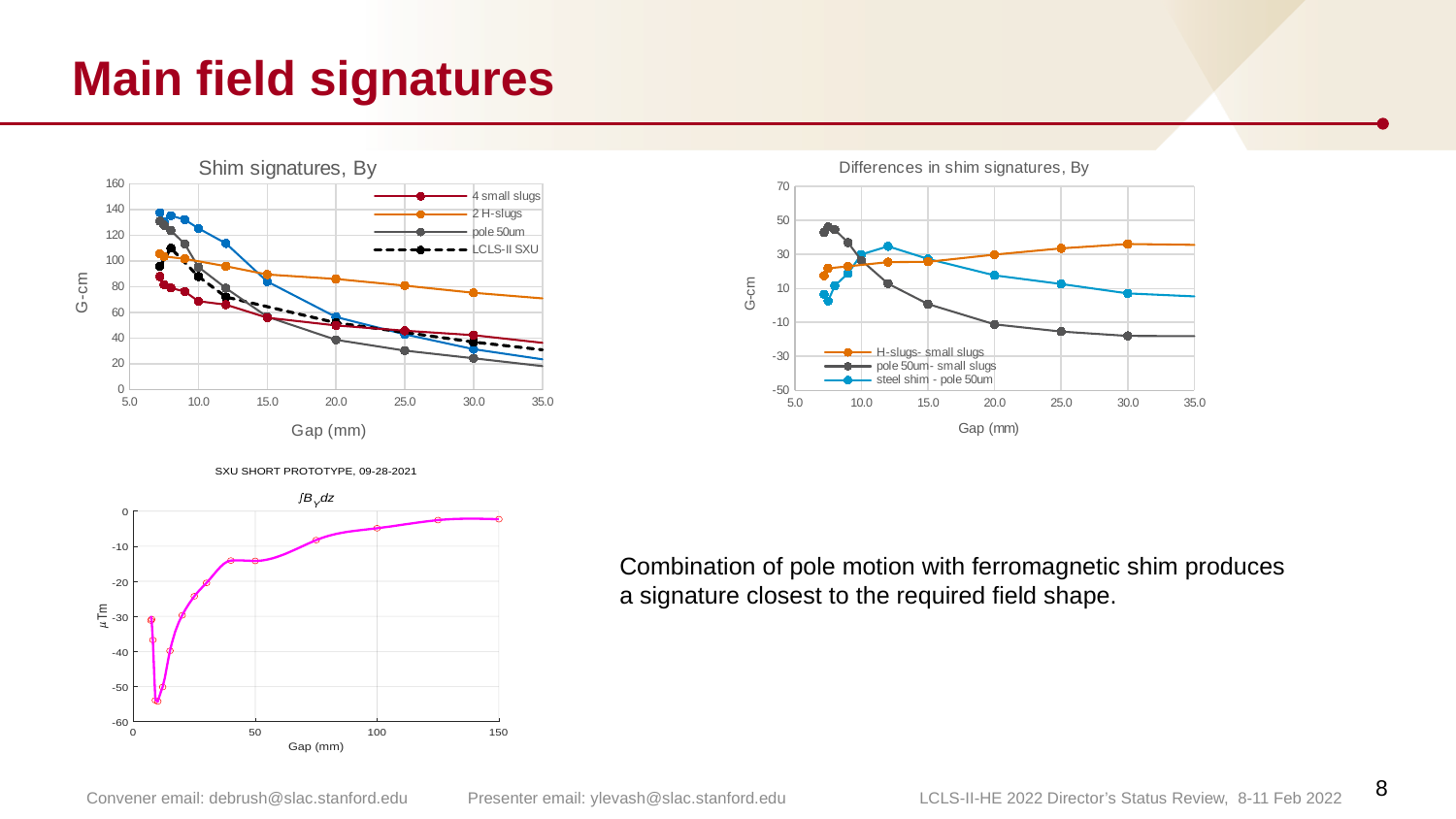
In the 'Differences in shim signatures, By' chart, how many series does the legend list? 3 In the 'Differences in shim signatures, By' chart, which series has the highest value at a gap of 35.0 mm? H-slugs- small slugs In the 'Shim signatures, By' chart, does the 'pole 50um' series rise or fall as the gap increases? fall In the 'Differences in shim signatures, By' chart, is the value for 'pole 50um- small slugs' at a gap of 30.0 mm greater or less than -10? less In the 'Shim signatures, By' chart, which series has the highest value at a gap of 35.0 mm? 2 H-slugs In the 'Shim signatures, By' chart, how many series does the legend list? 4 What kind of chart is the 'Shim signatures, By' chart? line chart In the 'Differences in shim signatures, By' chart, does the 'pole 50um- small slugs' series rise or fall as the gap increases from 10 mm to 30 mm? fall In the 'SXU SHORT PROTOTYPE, 09-28-2021' chart, is the minimum value greater or less than -50 μTm? less What is the y-axis label of the 'Differences in shim signatures, By' chart? G-cm In the 'Shim signatures, By' chart, is the value for 'pole 50um' at a gap of 35.0 mm greater or less than 40? less